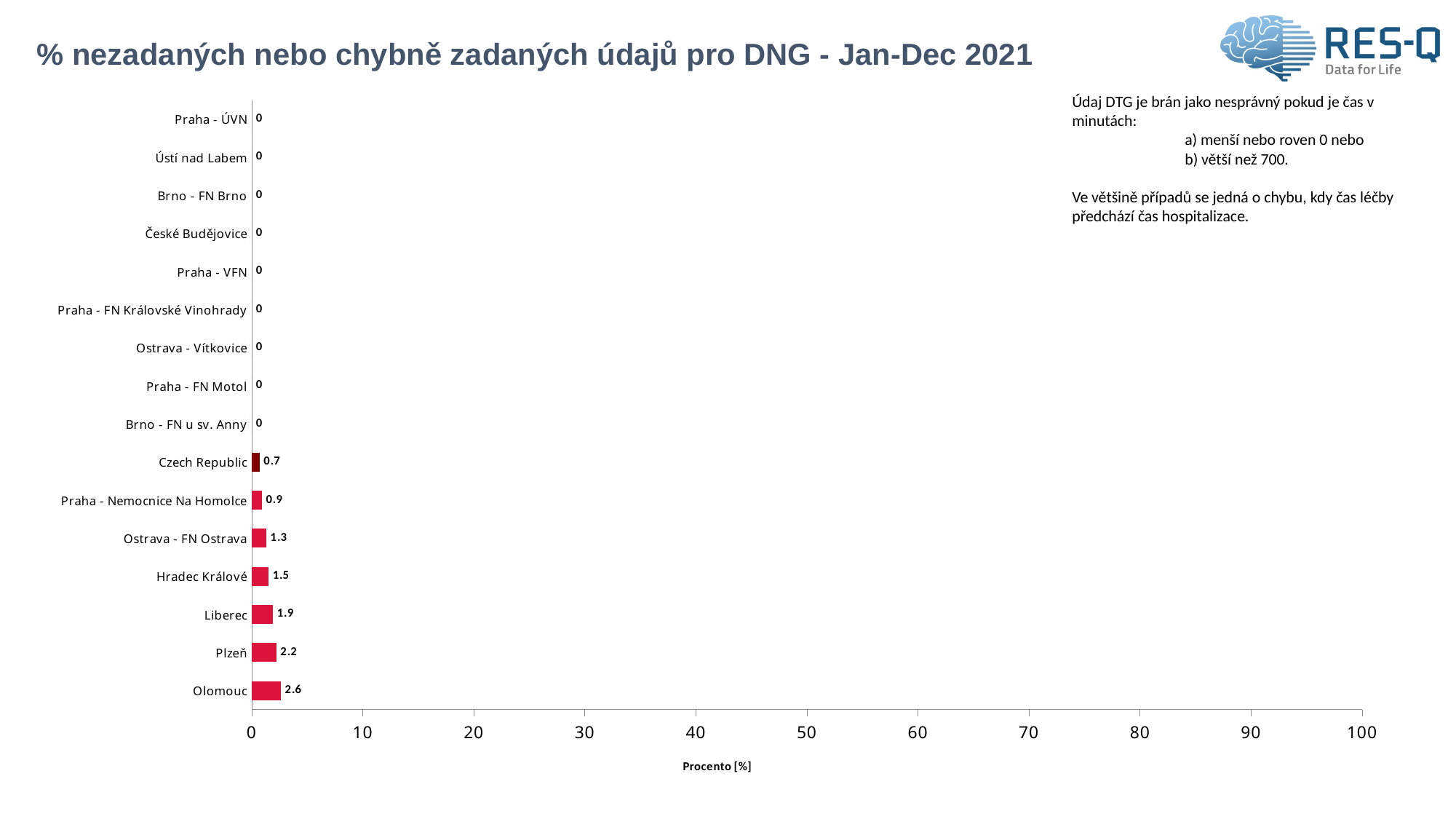
What is the value for Czech Republic? 0.7 Which category has the highest value? Olomouc How many categories are shown on the chart? 16 What is the difference between the values for Liberec and Ostrava - FN Ostrava? 0.6 What is the value for Praha - Nemocnice Na Homolce? 0.9 Which is larger, the value for Plzeň or the value for Liberec? Plzeň What is the value for Hradec Králové? 1.5 What is the value for Olomouc? 2.6 What kind of chart is shown on the slide? bar chart Is the value for Olomouc greater or less than 10? less What is the label of the x axis? Procento [%] What is the difference between the values for Olomouc and Plzeň? 0.4